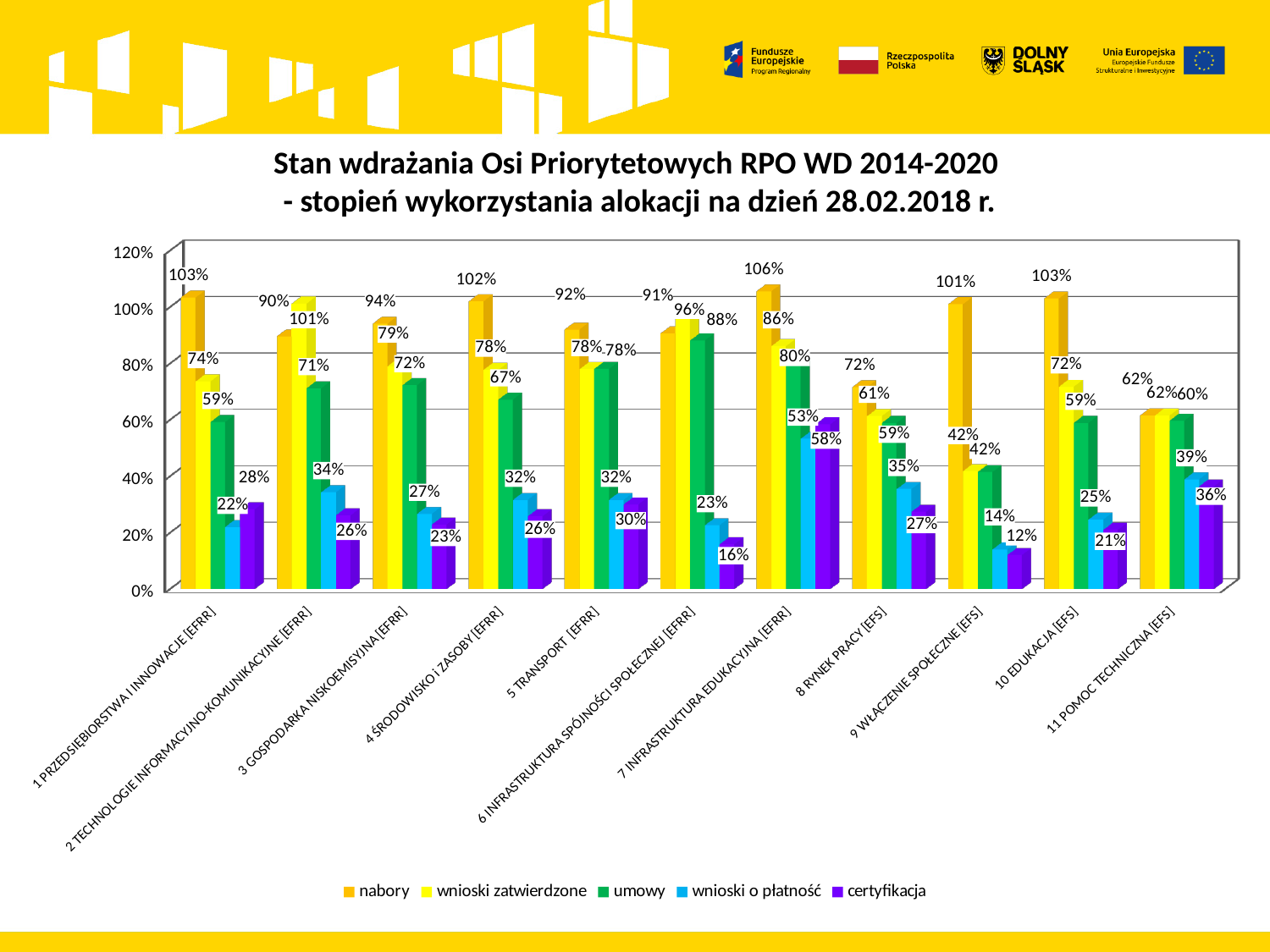
What type of chart is shown on the slide? bar chart What is the value of 'certyfikacja' for 1 PRZEDSIĘBIORSTWA I INNOWACJE [EFRR]? 28% Which legend entry is shown in green? umowy How many series does the legend list? 5 What is the difference between 'nabory' and 'wnioski zatwierdzone' for 9 WŁĄCZENIE SPOŁECZNE [EFS]? 59% What is the value of 'wnioski o płatność' for 11 POMOC TECHNICZNA [EFS]? 39% What is the value of 'umowy' for 6 INFRASTRUKTURA SPÓJNOŚCI SPOŁECZNEJ [EFRR]? 88% Which category has the lowest 'certyfikacja' value? 9 WŁĄCZENIE SPOŁECZNE [EFS] Which category has the highest 'nabory' value? 7 INFRASTRUKTURA EDUKACYJNA [EFRR] How many priority axes (categories) are shown on the x axis? 11 Which is larger for 2 TECHNOLOGIE INFORMACYJNO-KOMUNIKACYJNE [EFRR]: 'nabory' or 'wnioski zatwierdzone'? wnioski zatwierdzone What is the value of 'nabory' for 7 INFRASTRUKTURA EDUKACYJNA [EFRR]? 106%